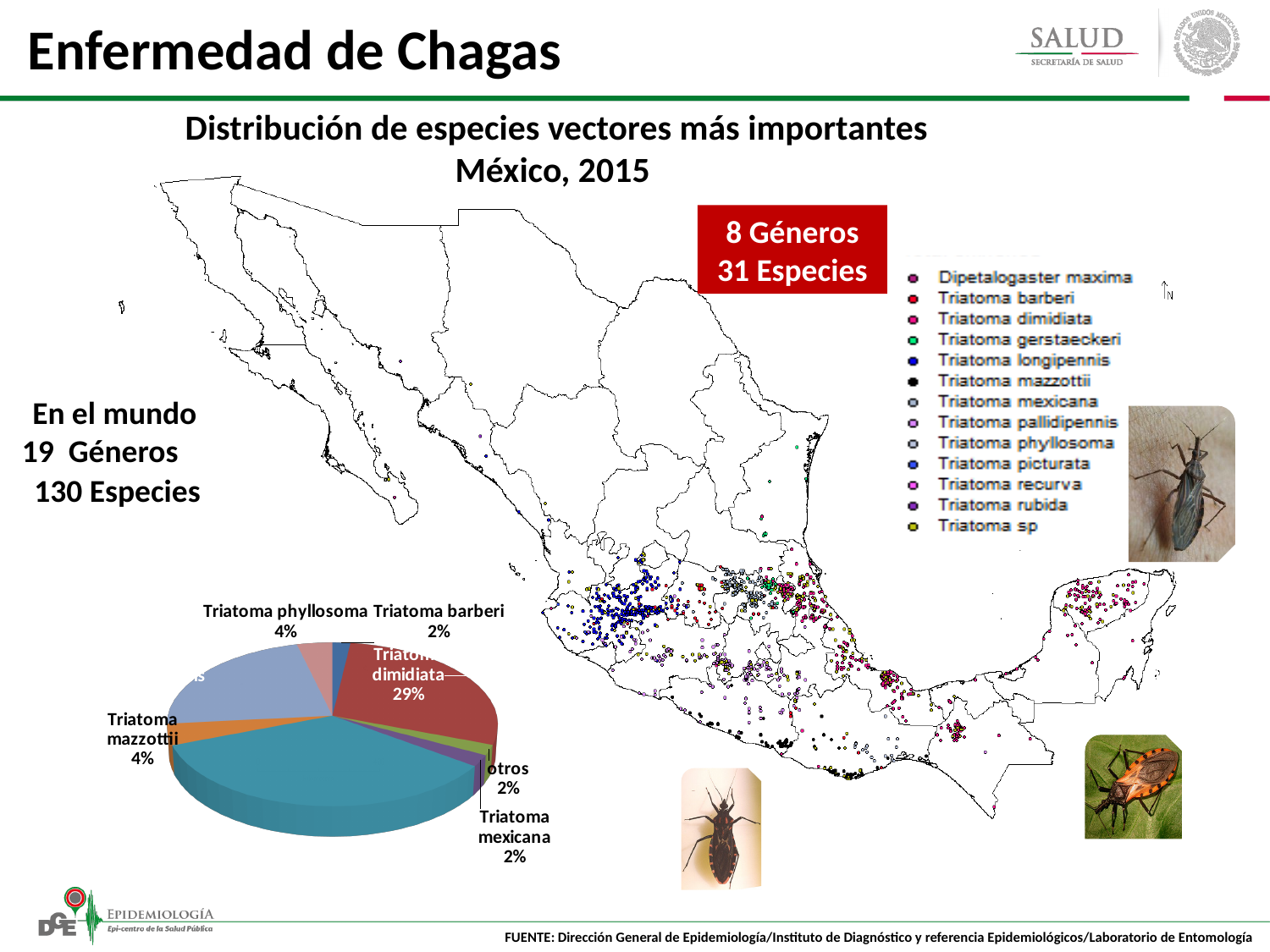
In the pie chart, what percentage share does Triatoma dimidiata have? 29% In the pie chart, which has the larger share, Triatoma dimidiata or Triatoma phyllosoma? Triatoma dimidiata In the pie chart, what percentage share does Triatoma mazzottii have? 4% What kind of chart is shown in the lower left of the slide? Pie chart In the pie chart, what percentage share does Triatoma mexicana have? 2% In the pie chart, what is the difference in percentage points between Triatoma dimidiata and Triatoma mazzottii? 25% In the pie chart, what percentage share does Triatoma phyllosoma have? 4% In the pie chart, what percentage share does Triatoma barberi have? 2% In the pie chart, what percentage share is labelled 'otros'? 2% In the pie chart, which has the larger share, Triatoma mazzottii or Triatoma barberi? Triatoma mazzottii In the pie chart, what is the difference in percentage points between Triatoma phyllosoma and Triatoma mexicana? 2% How many species are listed in the legend of the map? 13